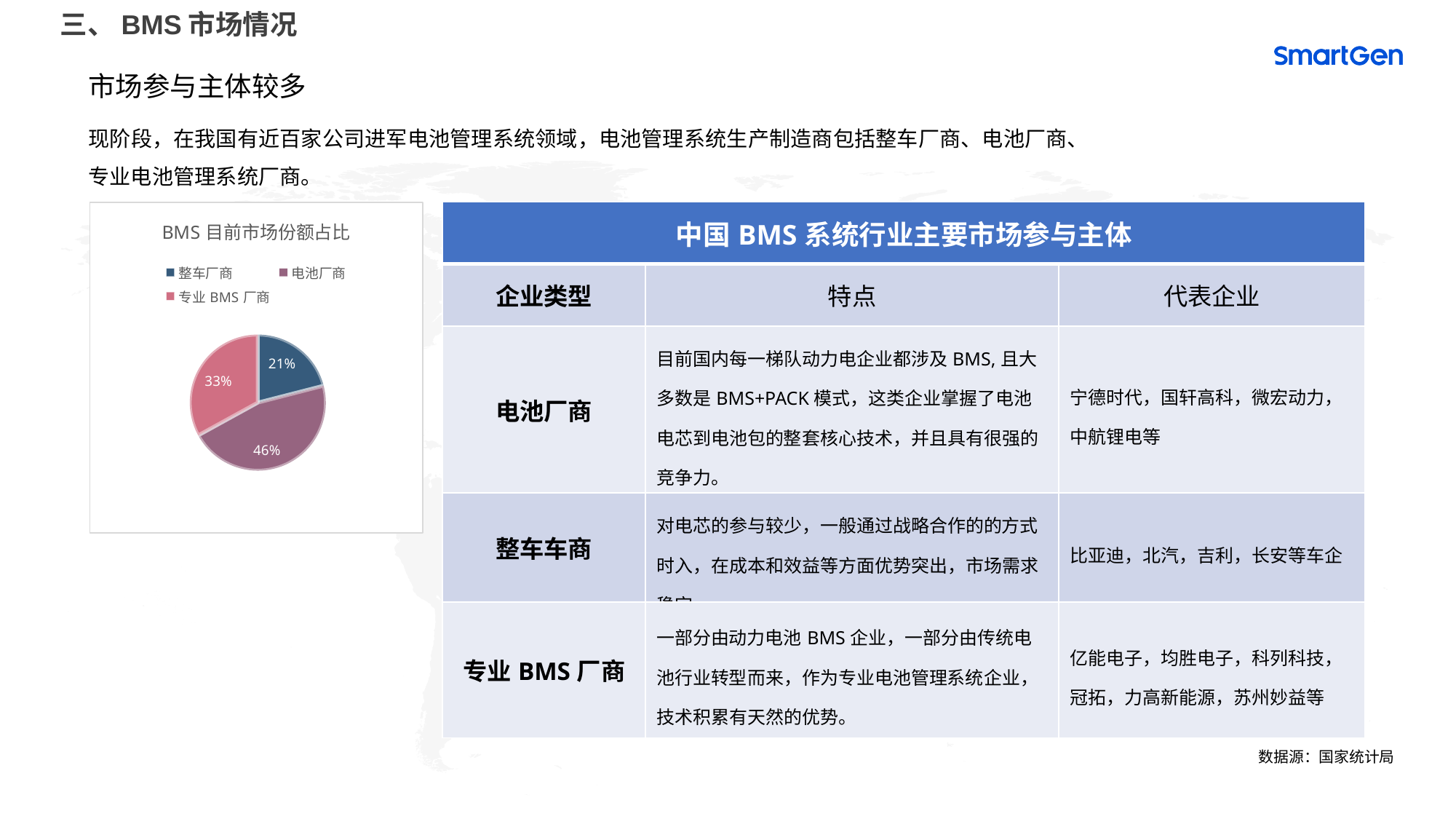
Which category has the smallest share of the pie? 整车厂商 Which has a larger share, 专业 BMS 厂商 or 整车厂商? 专业 BMS 厂商 What share of the pie does 专业 BMS 厂商 hold? 33% What is the title of the chart? BMS 目前市场份额占比 What share of the pie does 电池厂商 hold? 46% What share of the pie does 整车厂商 hold? 21% How many entries does the legend list? 3 How many slices does the pie chart have? 3 What is the difference in share between 电池厂商 and 整车厂商? 25% What type of chart is shown on the slide? pie chart What is the difference in share between 专业 BMS 厂商 and 整车厂商? 12% Which category has the largest share of the pie? 电池厂商